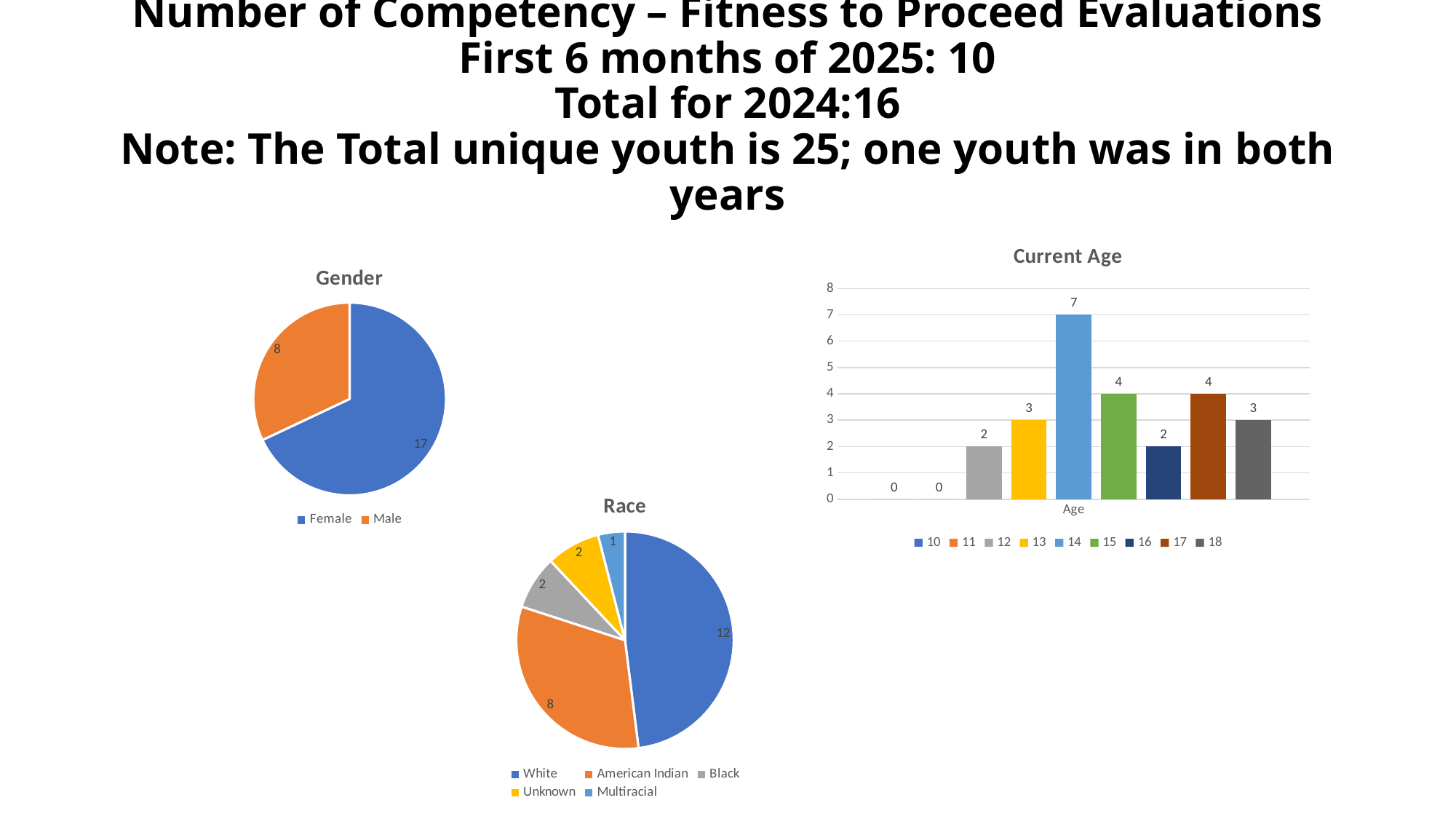
In the Current Age chart, which age has the highest value? 14 What kind of chart is the Current Age chart? Bar chart In the Race pie chart, what share of the total is White? 48% In the Current Age chart, how many series does the legend list? 9 In the Gender pie chart, what share of the total is Male? 32% In the Race pie chart, how many are American Indian? 8 In the Race pie chart, how many categories does the legend list? 5 In the Gender pie chart, what is the difference between the Female and Male counts? 9 In the Current Age chart, what is the value for age 14? 7 In the Race pie chart, which category has the smallest slice? Multiracial In the Current Age chart, which is larger, the value for age 13 or the value for age 15? 15 In the Gender pie chart, how many are Female? 17